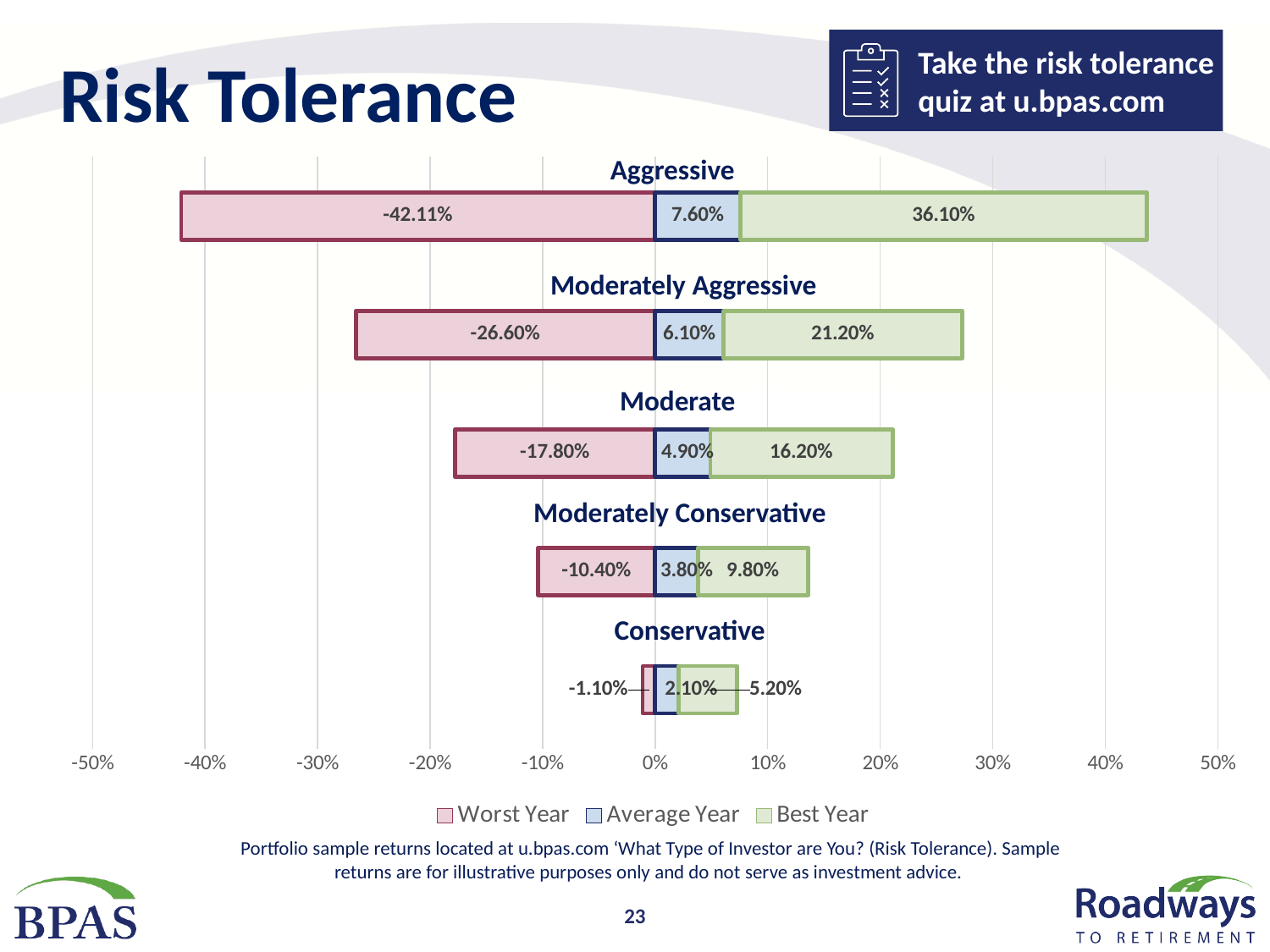
Which series is shown in green in the legend? Best Year How many portfolio categories are shown in the chart? 5 What kind of chart is shown on the slide? Bar chart What is the Best Year value for the Conservative portfolio? 5.20% Which is larger, the Average Year value for Moderately Conservative or for Conservative? Moderately Conservative What is the difference between the Best Year values of the Aggressive and Moderately Aggressive portfolios? 14.90% Which portfolio has the highest Best Year value? Aggressive How many series does the legend list? 3 What is the Worst Year value for the Aggressive portfolio? -42.11% What is the Best Year value for the Moderately Aggressive portfolio? 21.20% Which portfolio has the lowest Worst Year value? Aggressive What is the Average Year value for the Moderate portfolio? 4.90%